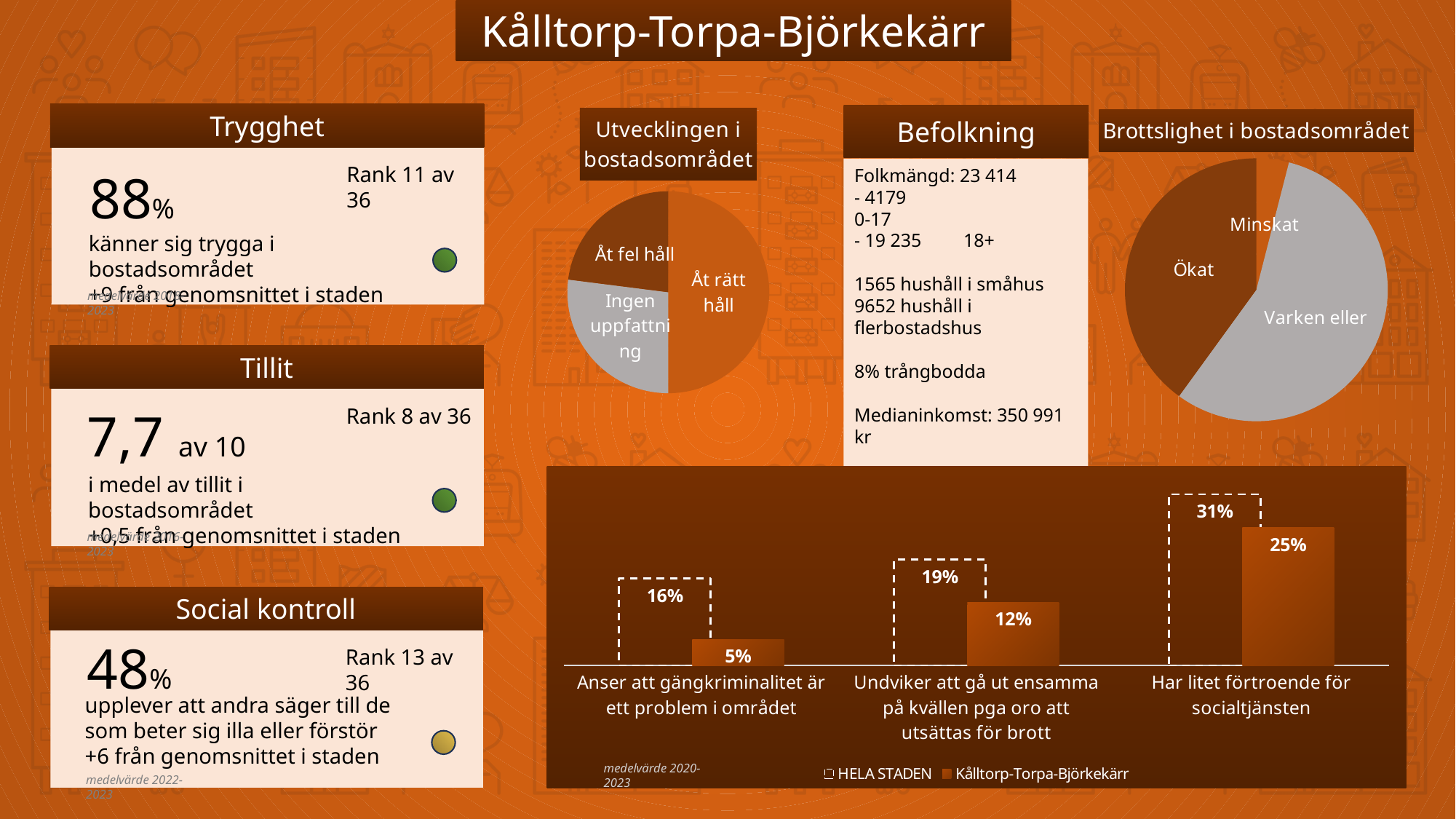
How many series does the legend of the bottom bar chart list? 2 How many categories are shown in the bottom bar chart? 3 In the 'Utvecklingen i bostadsområdet' pie chart, which slice is the largest? Åt rätt håll In the bottom bar chart, what is the value for HELA STADEN for 'Anser att gängkriminalitet är ett problem i området'? 16% What kind of chart is 'Brottslighet i bostadsområdet'? Pie chart In the bottom bar chart, what is the difference between HELA STADEN and Kålltorp-Torpa-Björkekärr for 'Anser att gängkriminalitet är ett problem i området'? 11% In the bottom bar chart, which category has the highest value for HELA STADEN? Har litet förtroende för socialtjänsten In the bottom bar chart, what is the value for Kålltorp-Torpa-Björkekärr for 'Har litet förtroende för socialtjänsten'? 25% In the 'Brottslighet i bostadsområdet' pie chart, which slice is the largest? Varken eller In the bottom bar chart, which is larger for 'Undviker att gå ut ensamma på kvällen pga oro att utsättas för brott': HELA STADEN or Kålltorp-Torpa-Björkekärr? HELA STADEN In the bottom bar chart, what is the value for Kålltorp-Torpa-Björkekärr for 'Undviker att gå ut ensamma på kvällen pga oro att utsättas för brott'? 12% In the bottom bar chart, which category has the lowest value for Kålltorp-Torpa-Björkekärr? Anser att gängkriminalitet är ett problem i området